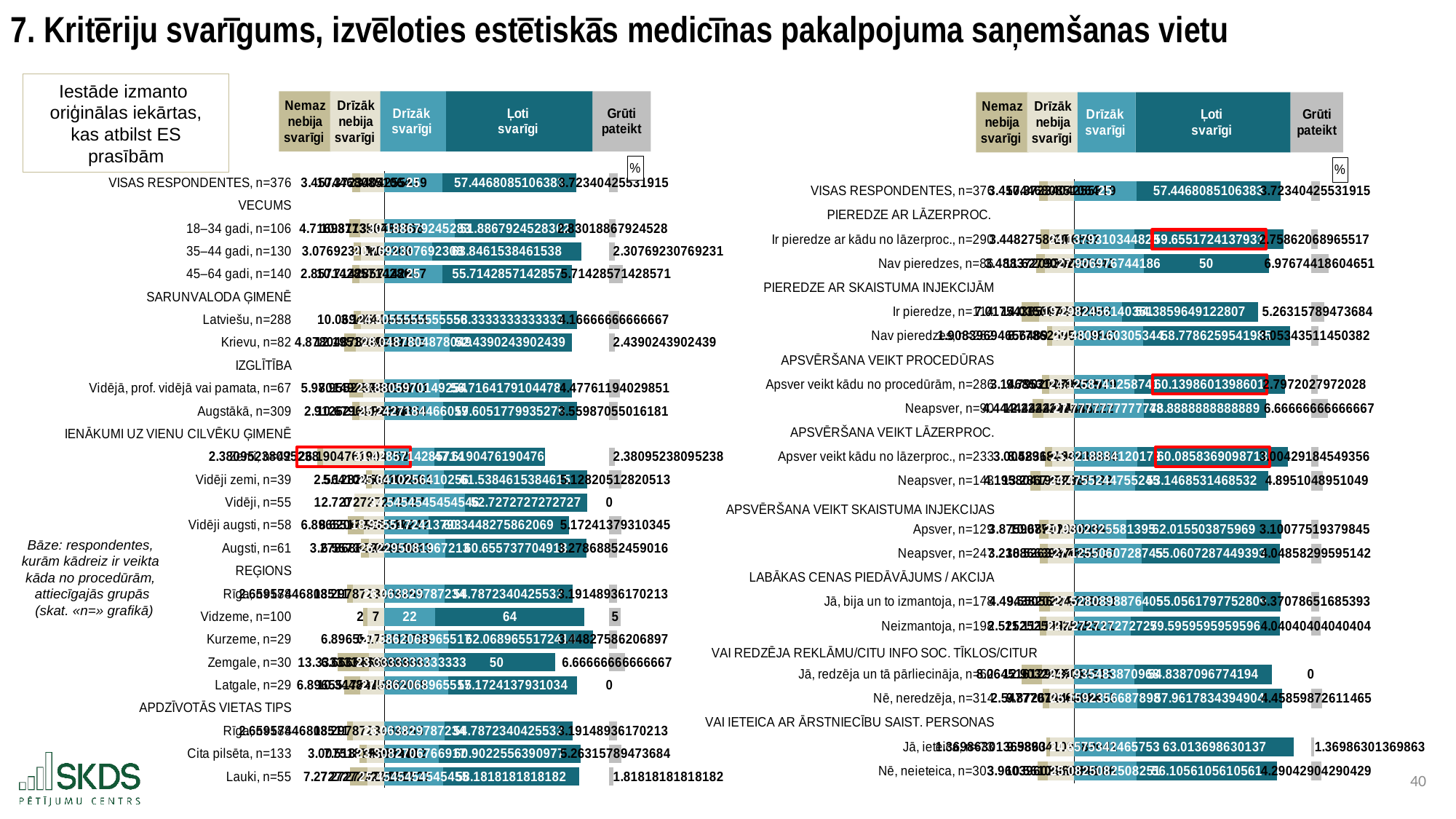
In the left chart, which has the larger 'Ļoti svarīgi' value: Vidzeme, n=100 or Zemgale, n=30? Vidzeme, n=100 In the left chart, what is the 'Ļoti svarīgi' value for Vidzeme, n=100? 64 In the left chart, what is the 'Drīzāk svarīgi' value for Vidzeme, n=100? 22 In the left chart, what is the total of the stacked bar for Vidzeme, n=100? 100 What criterion is named in the box at the top left of the slide? Iestāde izmanto oriģinālas iekārtas, kas atbilst ES prasībām In the left chart, what is the 'Grūti pateikt' value for Vidzeme, n=100? 5 In the left chart, what is the difference between the 'Ļoti svarīgi' values for Vidzeme, n=100 and Zemgale, n=30? 14 How many series does the legend list for the charts? 5 What kind of chart is used on this slide? bar chart In the right chart, what is the 'Ļoti svarīgi' value for Nav pieredzes, n=86? 50 In the left chart, what is the 'Ļoti svarīgi' value for Zemgale, n=30? 50 In the right chart, what is the 'Grūti pateikt' value for Jā, redzēja un tā pārliecināja? 0